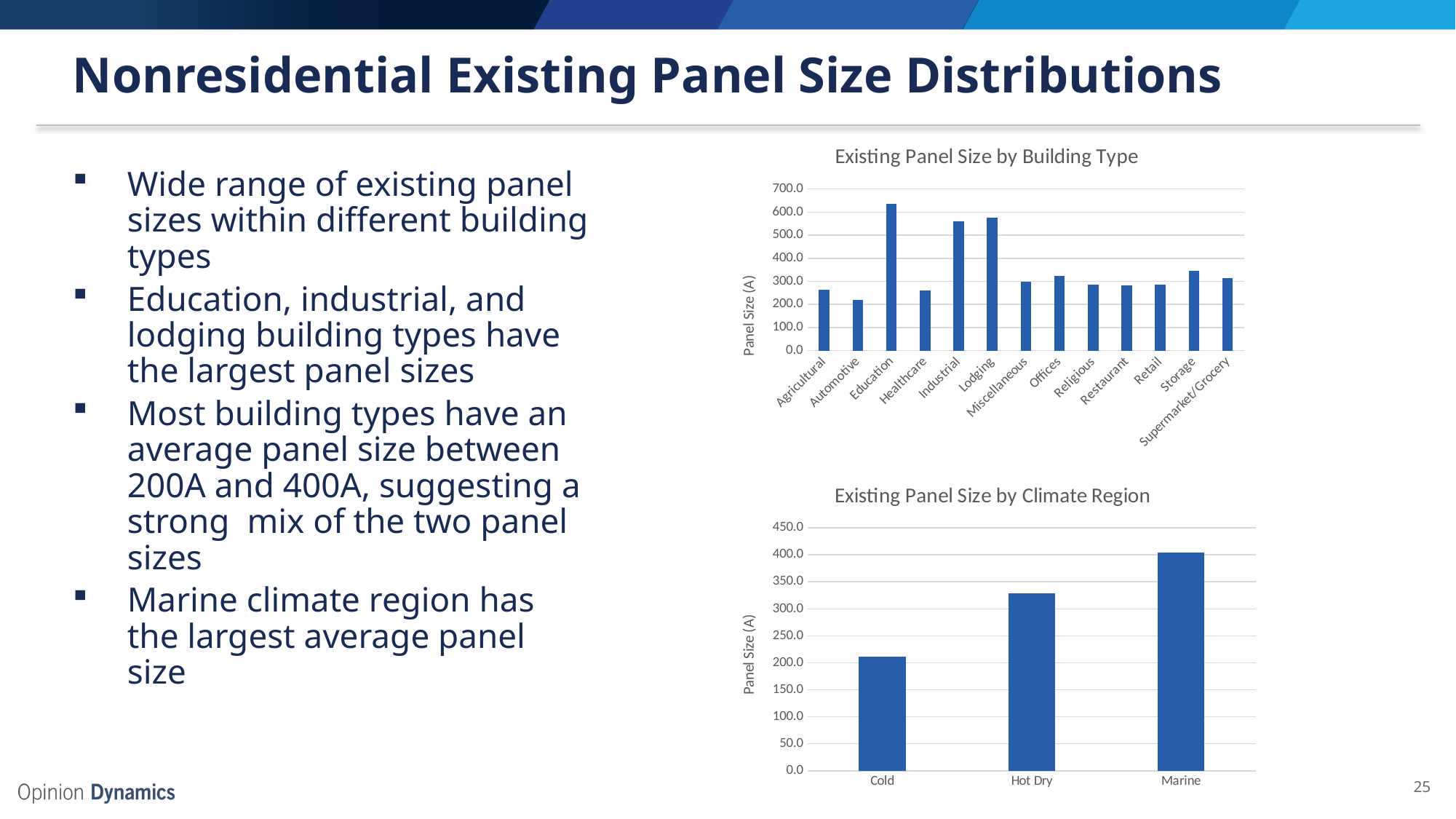
What kind of chart is 'Existing Panel Size by Building Type'? bar chart In the 'Existing Panel Size by Building Type' chart, which is larger, the value for Lodging or the value for Retail? Lodging In the 'Existing Panel Size by Climate Region' chart, how many climate regions are shown? 3 In the 'Existing Panel Size by Climate Region' chart, which climate region has the largest panel size? Marine In the 'Existing Panel Size by Building Type' chart, is the value for Industrial greater or less than 500.0? greater In the 'Existing Panel Size by Building Type' chart, is the value for Education greater or less than 600.0? greater What is the y-axis label of the 'Existing Panel Size by Climate Region' chart? Panel Size (A) In the 'Existing Panel Size by Climate Region' chart, is the value for Hot Dry greater or less than 300.0? greater In the 'Existing Panel Size by Building Type' chart, which building type has the largest panel size? Education In the 'Existing Panel Size by Building Type' chart, how many building types are shown? 13 In the 'Existing Panel Size by Building Type' chart, which building type has the smallest panel size? Automotive